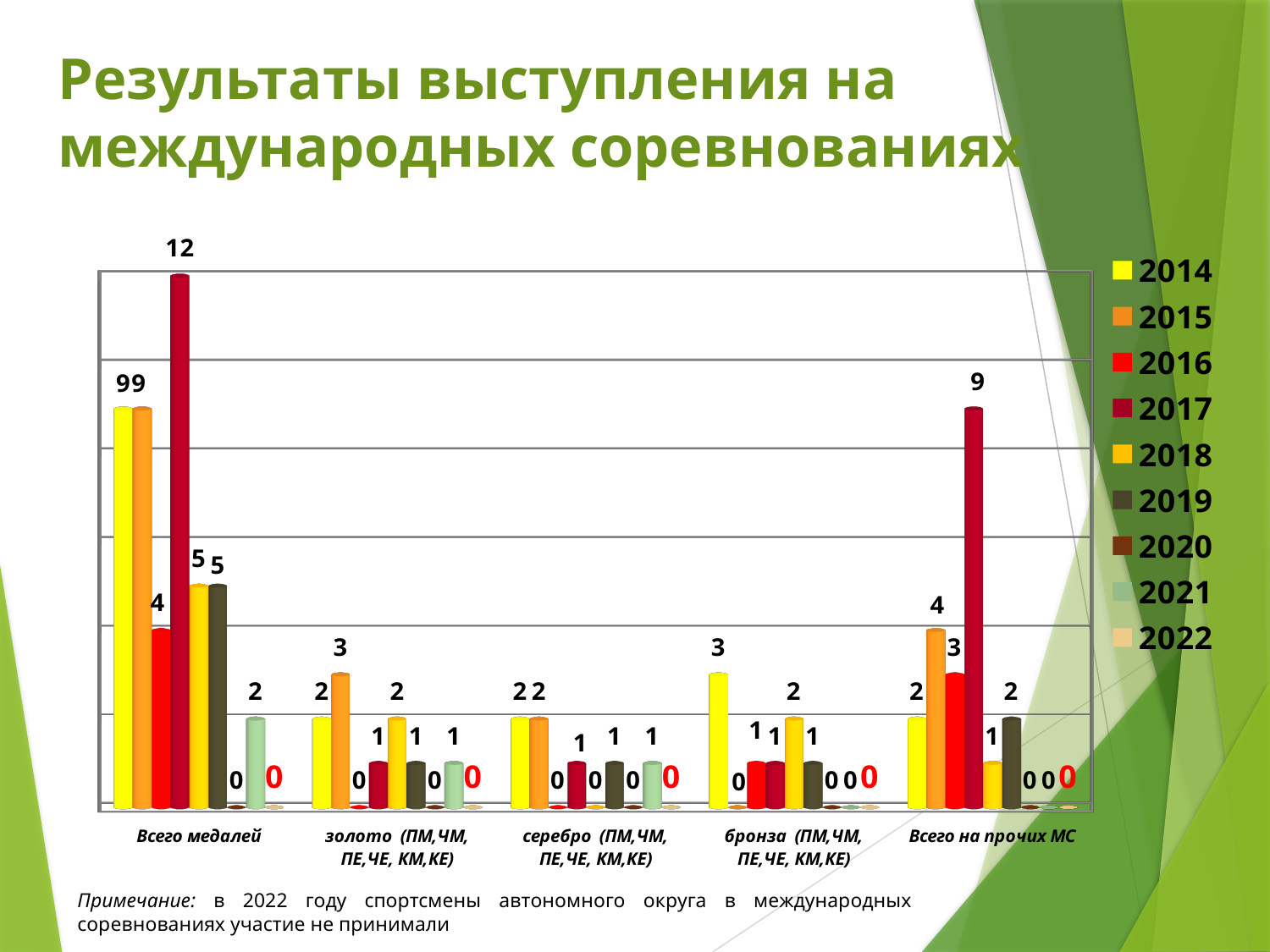
What type of chart is shown on the slide? bar chart Which legend entry is shown in yellow? 2014 What is the value for 2017 in the 'Всего медалей' category? 12 What is the value for 2015 in the 'золото (ПМ,ЧМ, ПЕ,ЧЕ, КМ,КЕ)' category? 3 What is the value for 2014 in the 'бронза (ПМ,ЧМ, ПЕ,ЧЕ, КМ,КЕ)' category? 3 What is the value for 2017 in the 'Всего на прочих МС' category? 9 What is the value for 2021 in the 'Всего медалей' category? 2 How many series does the legend list? 9 How many categories are shown on the x axis? 5 What is the difference between the 2017 and 2016 values in the 'Всего медалей' category? 8 Which is larger in the 'Всего на прочих МС' category: the value for 2015 or the value for 2016? 2015 Which year has the highest value in the 'Всего медалей' category? 2017